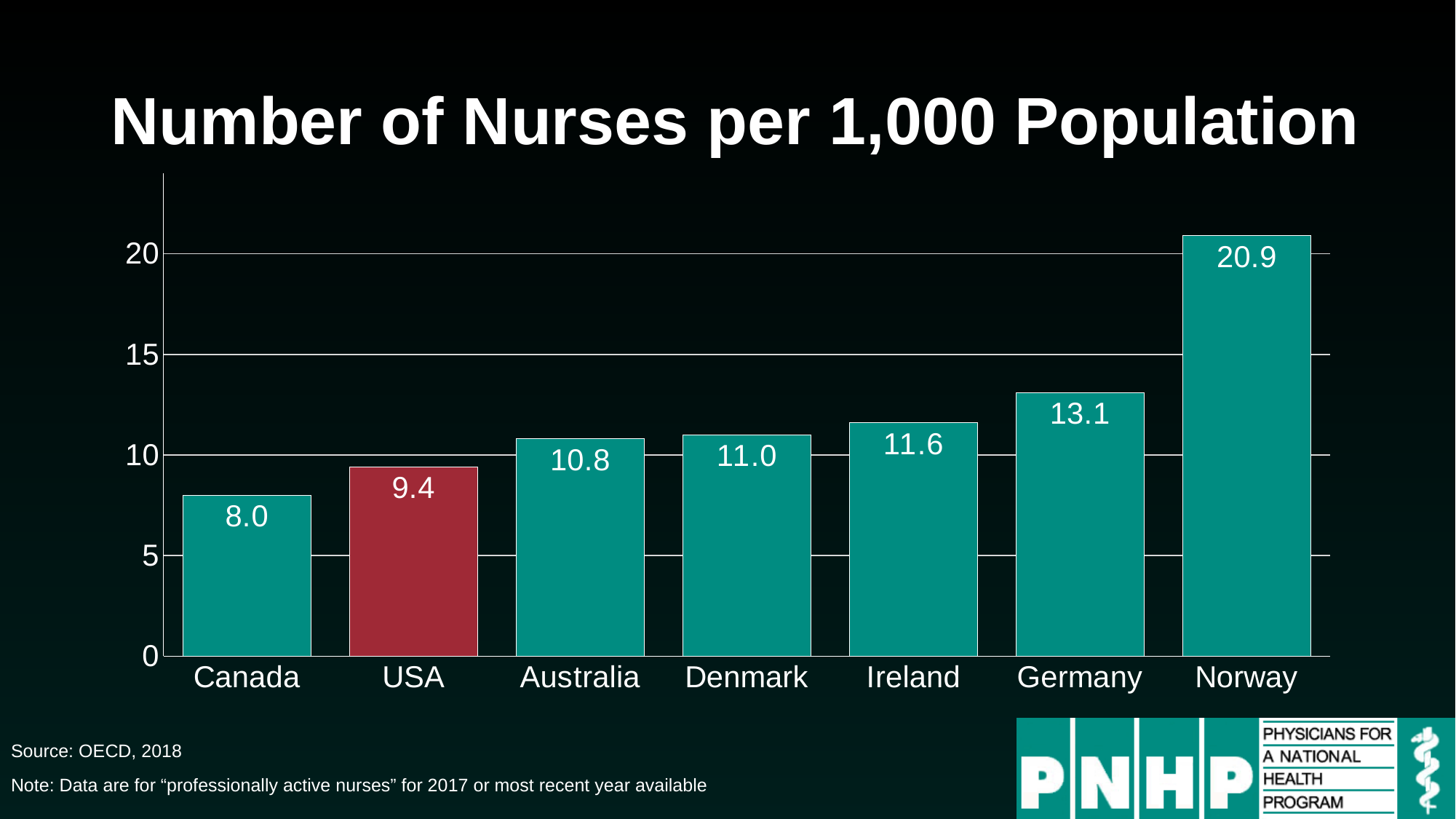
Which country has the lowest number of nurses per 1,000 population? Canada How many countries are shown in the chart? 7 What is the number of nurses per 1,000 population for the USA? 9.4 Which country has the highest number of nurses per 1,000 population? Norway What kind of chart is shown on the slide? bar chart What is the difference between Norway's and Canada's number of nurses per 1,000 population? 12.9 What is the number of nurses per 1,000 population for Germany? 13.1 Is the value for Germany greater or less than 15? less What is the difference between Ireland's and the USA's number of nurses per 1,000 population? 2.2 Which has a higher number of nurses per 1,000 population, Denmark or Australia? Denmark Which country's bar is coloured differently (red) from the others? USA Do the values rise or fall from left to right across the countries? rise